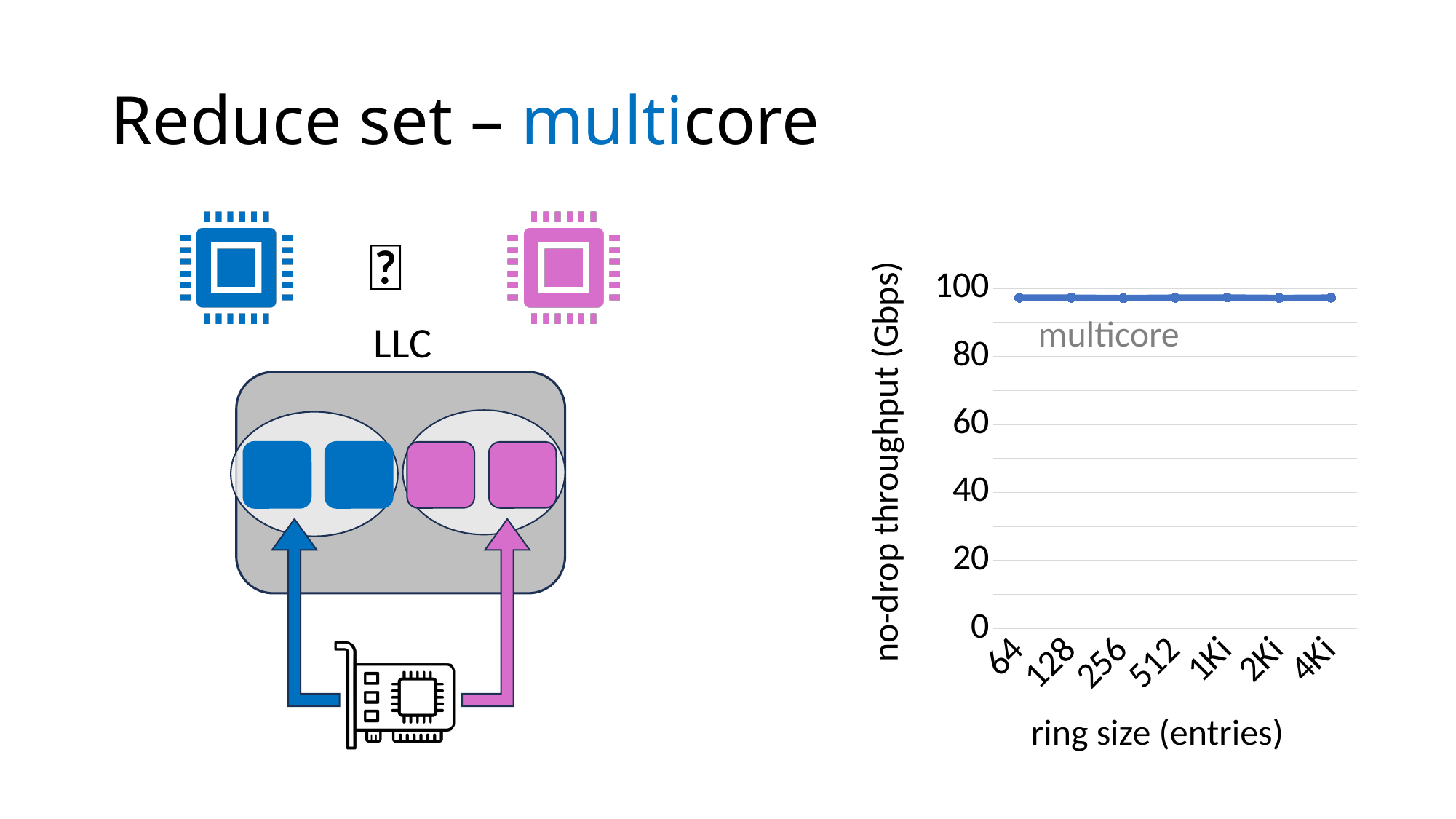
How many ring size values are plotted along the x axis? 7 Is the multicore throughput at ring size 64 greater or less than 80? greater What is the highest tick value shown on the y axis? 100 What is the largest ring size shown on the x axis? 4Ki Does the multicore throughput rise, fall, or stay roughly flat as ring size increases from 64 to 4Ki? stays roughly flat What is the smallest ring size shown on the x axis? 64 Is the multicore throughput at ring size 4Ki greater or less than 100? less Is the multicore throughput at ring size 512 greater or less than 60? greater What kind of chart is shown on the slide? line chart What is the label of the y axis? no-drop throughput (Gbps) How many series does the chart show? 1 What is the name of the series plotted in the chart? multicore